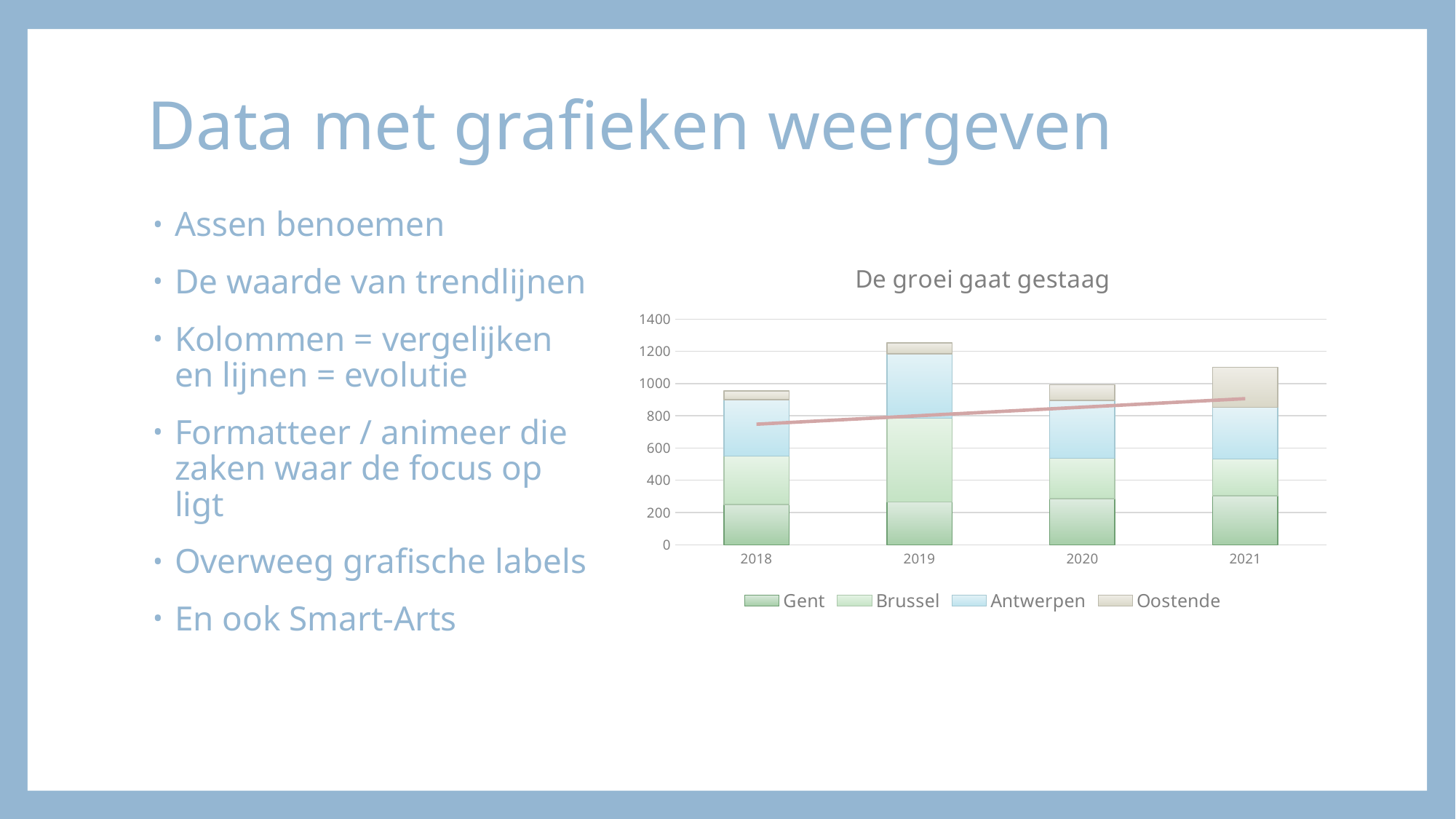
Is the total stacked bar for 2019 greater or less than 1200? greater Is the total stacked bar for 2021 greater or less than 1000? greater Which series is listed last in the chart legend? Oostende What kind of chart is shown on the slide? stacked bar chart with a line (combination bar and line chart) What is the title of the chart? De groei gaat gestaag Does the trend line drawn across the chart rise or fall from 2018 to 2021? rise Is the total stacked bar for 2018 greater or less than 1000? less How many series does the chart legend list? 4 How many years are shown on the x axis of the chart? 4 Which is larger, the total stacked bar for 2019 or for 2021? 2019 Which year has the highest total stacked bar? 2019